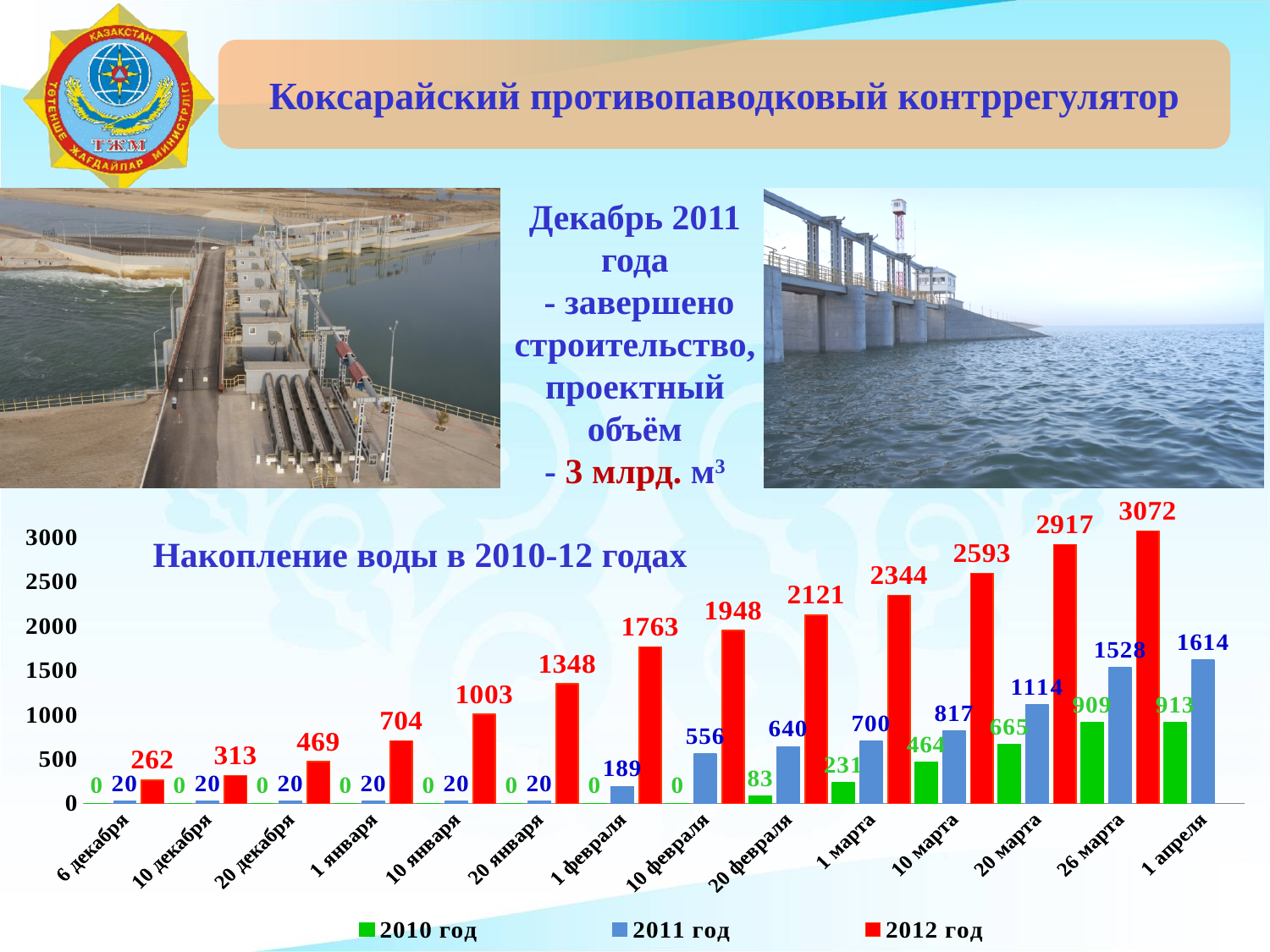
What is the value for 2010 год on 10 марта? 464 How many dates are shown on the x axis? 14 What kind of chart is shown? bar chart What is the difference between the 2012 год values on 26 марта and 20 марта? 155 How many series does the legend list? 3 Which is larger on 1 марта: the 2011 год value or the 2010 год value? 2011 год What is the value for 2012 год on 1 февраля? 1763 What is the value for 2011 год on 26 марта? 1528 What is the title of the chart? Накопление воды в 2010-12 годах Does the 2012 год series rise or fall from 6 декабря to 26 марта? rise Which date has the highest value for the 2011 год series? 1 апреля Which date has the highest value for the 2012 год series? 26 марта